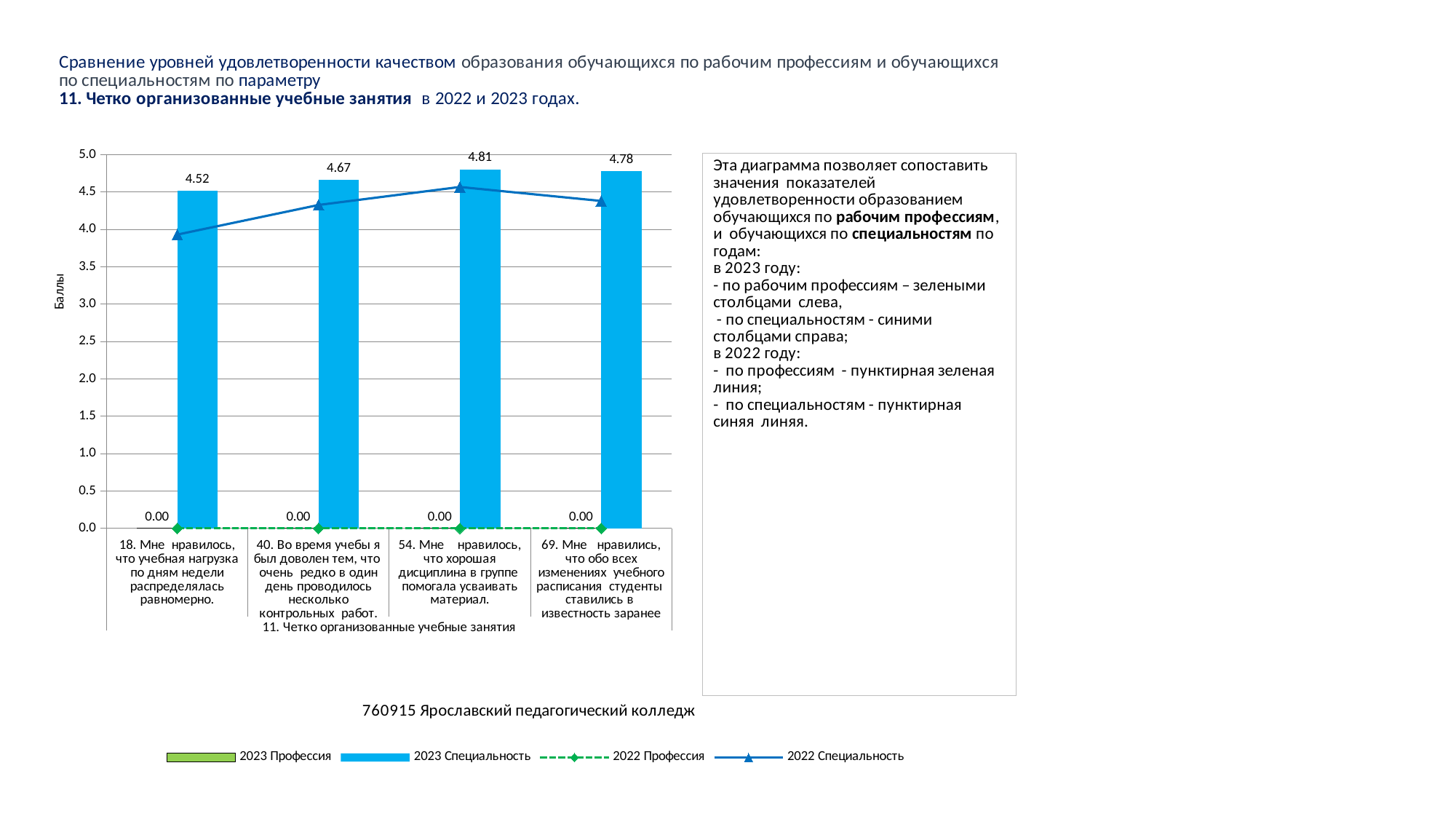
Which category has the highest 2023 Специальность value? 54. Мне нравилось, что хорошая дисциплина в группе помогала усваивать материал. Do the 2023 Специальность values rise or fall from category 18 to category 54? rise Which category has the lowest 2023 Специальность value? 18. Мне нравилось, что учебная нагрузка по дням недели распределялась равномерно. What is the value of the 2023 Специальность series for category 54 (Мне нравилось, что хорошая дисциплина в группе помогала усваивать материал)? 4.81 What is the title of the y axis? Баллы What is the value of the 2023 Специальность series for category 18 (Мне нравилось, что учебная нагрузка по дням недели распределялась равномерно)? 4.52 Is the 2022 Специальность value for category 40 greater or less than 4.5? less How many series does the legend list? 4 How many categories are shown on the x axis? 4 Which has the larger 2023 Специальность value: category 40 or category 69? Category 69 What is the value of the 2023 Профессия series for category 69? 0.00 What is the difference between the 2023 Специальность values for category 54 and category 18? 0.29